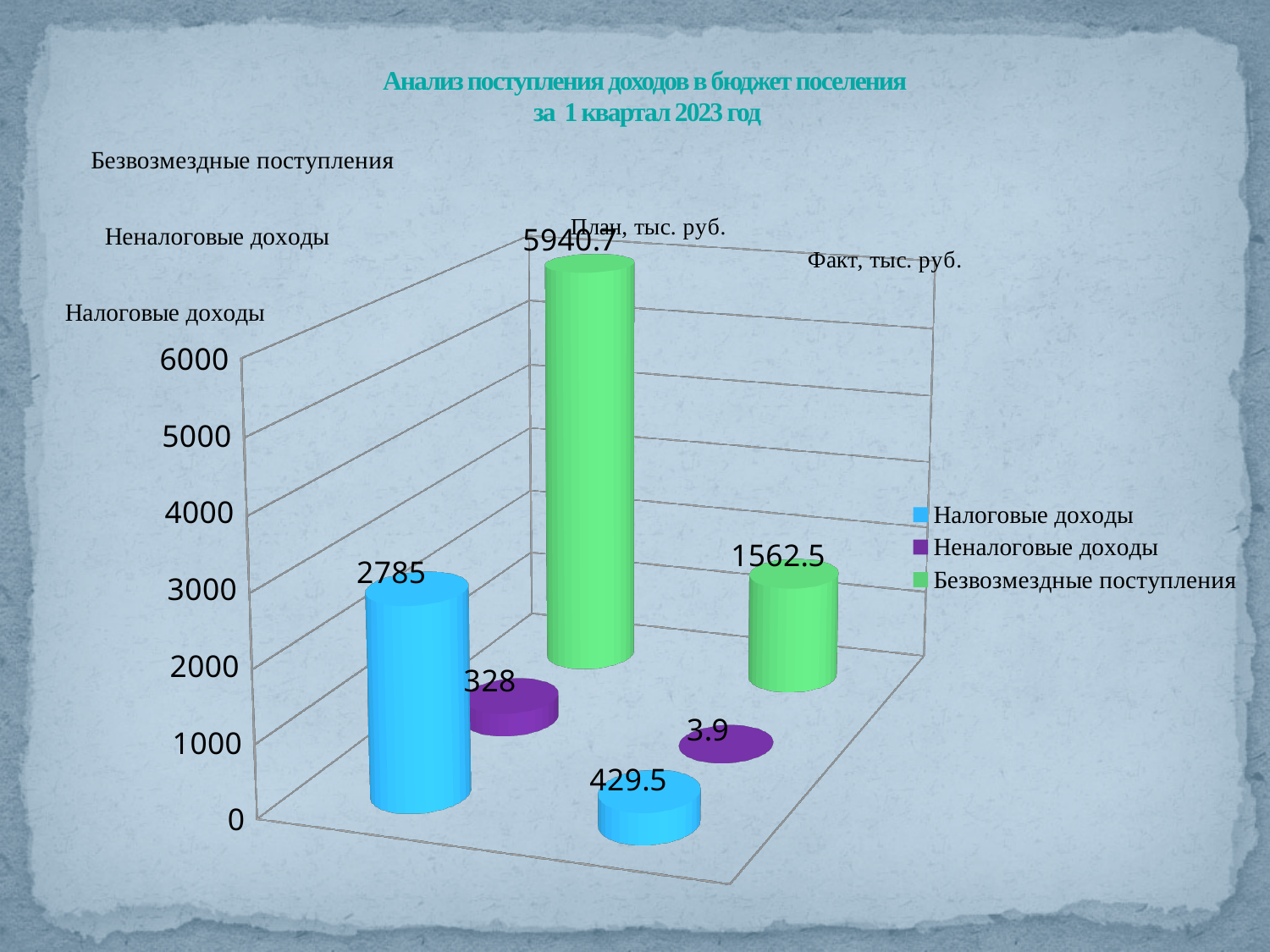
Which is larger: the planned value for Неналоговые доходы or the actual value for Налоговые доходы? Actual value for Налоговые доходы What type of chart is shown on the slide? Bar chart What is the actual value (Факт, тыс. руб.) for Неналоговые доходы? 3.9 Which series has the lowest actual value (Факт, тыс. руб.)? Неналоговые доходы What is the difference between the planned and actual values for Безвозмездные поступления? 4378.2 What is the actual value (Факт, тыс. руб.) for Налоговые доходы? 429.5 How many series does the legend list? 3 What is the title of the chart? Анализ поступления доходов в бюджет поселения за 1 квартал 2023 год What is the planned value (План, тыс. руб.) for Безвозмездные поступления? 5940.7 How many categories are shown on the x axis? 2 What is the planned value (План, тыс. руб.) for Налоговые доходы? 2785 Which series has the highest planned value (План, тыс. руб.)? Безвозмездные поступления